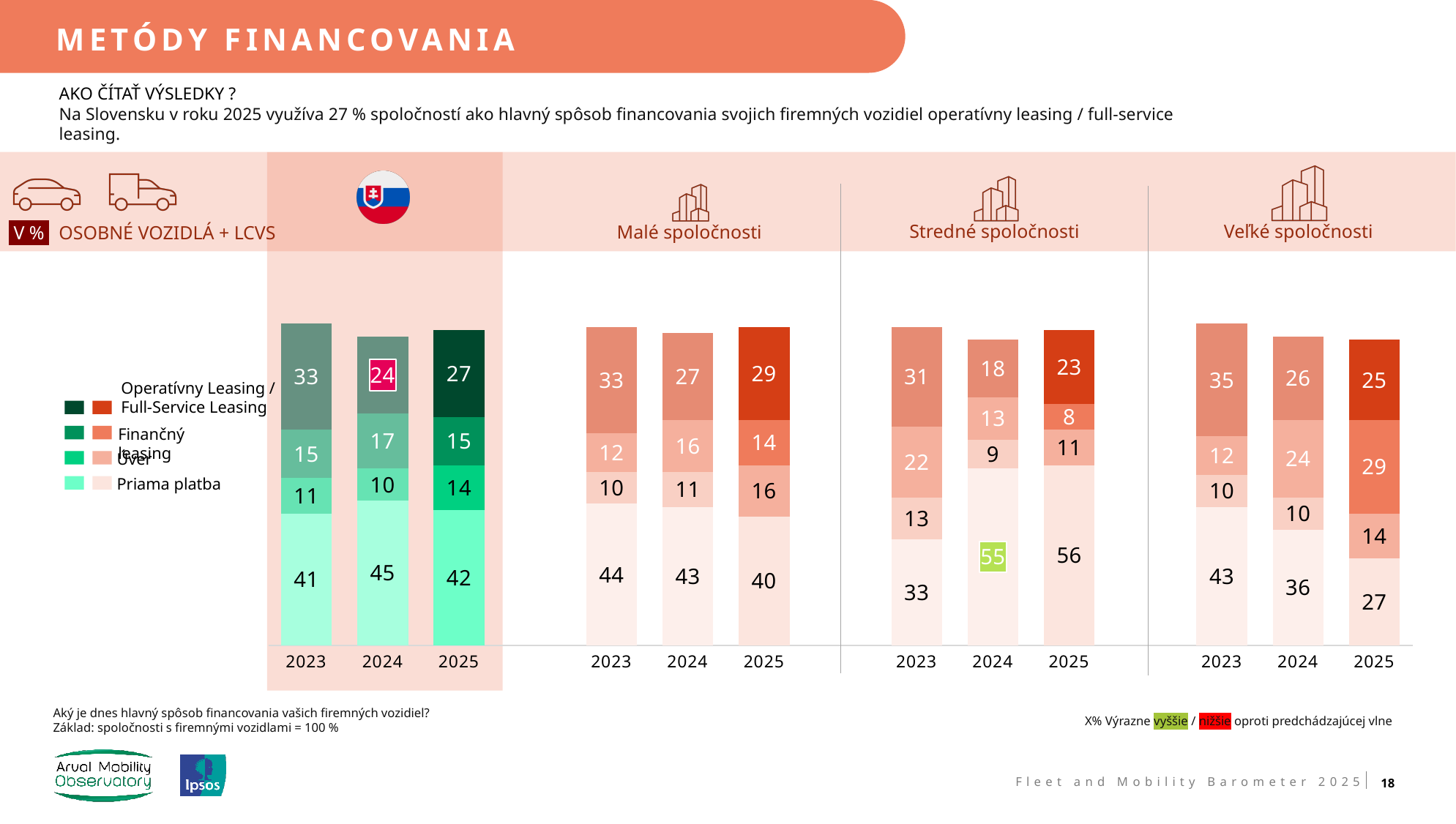
In the Veľké spoločnosti chart, which year has the lowest value for Priama platba? 2025 In the Malé spoločnosti chart, what is the value for Priama platba in 2023? 44 In the Veľké spoločnosti chart, what is the difference between the Finančný leasing values for 2025 and 2023? 17 In the Stredné spoločnosti chart, does the Finančný leasing value rise or fall from 2023 to 2025? Fall How many series does the legend list? 4 How many years are shown on the x axis of the Stredné spoločnosti chart? 3 In the Stredné spoločnosti chart, which year has the highest value for Priama platba? 2025 In the Stredné spoločnosti chart, what is the value for Finančný leasing in 2025? 8 In the Veľké spoločnosti chart, what is the value for Úver in 2025? 14 In the Slovakia overall chart (Osobné vozidlá + LCVs), what is the value for Operatívny Leasing / Full-Service Leasing in 2025? 27 In the Malé spoločnosti chart, is the Operatívny Leasing / Full-Service Leasing value larger in 2023 or in 2025? 2023 What kind of chart is used for the Malé spoločnosti data? Stacked bar chart